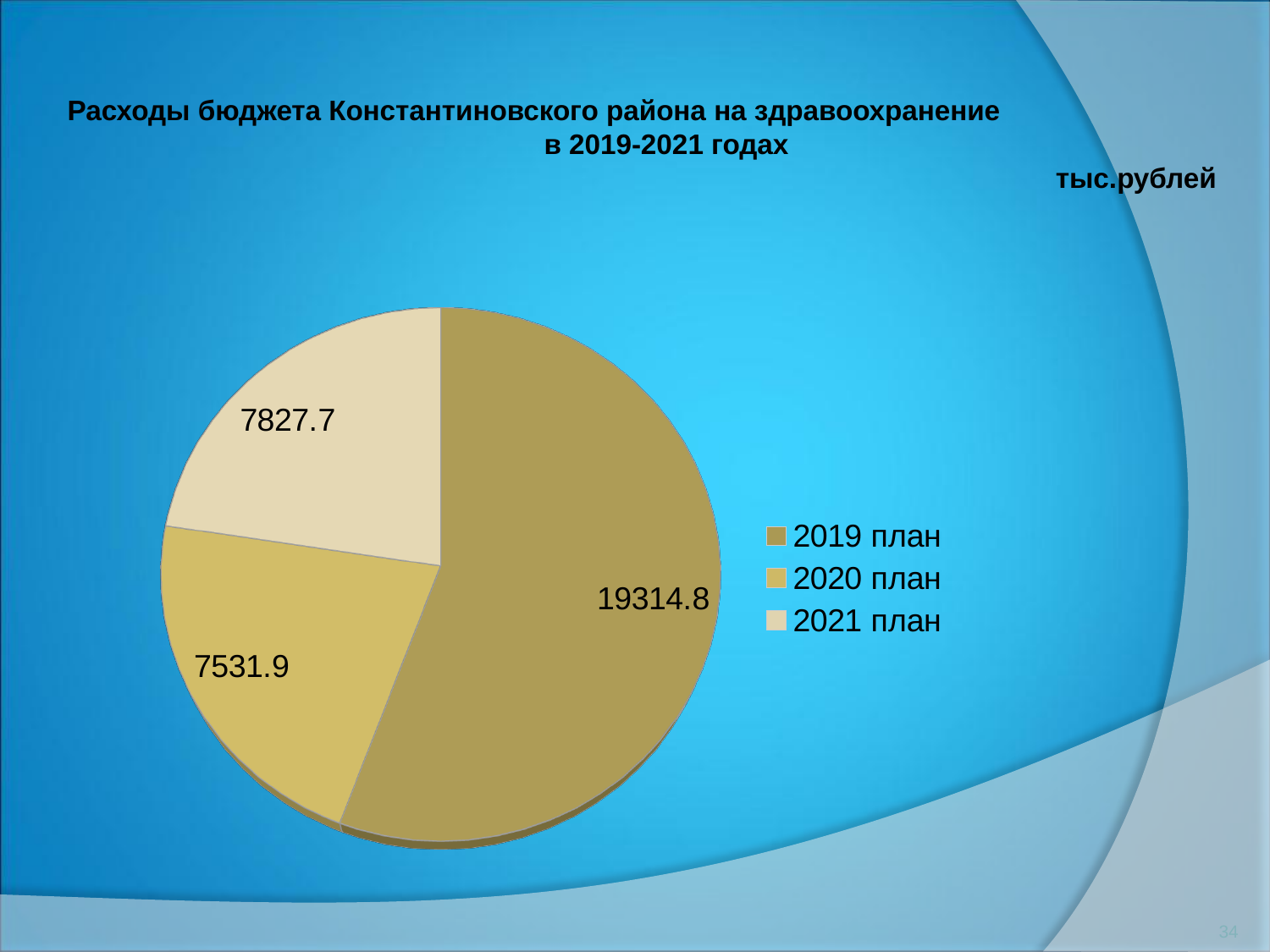
What is the value for 2019 план? 19314.8 What is the difference between the values for 2019 план and 2021 план? 11487.1 Which category has the largest slice of the pie? 2019 план What is the value for 2020 план? 7531.9 How many slices does the pie chart have? 3 In what units are the values on the chart expressed? тыс.рублей Which is larger, the value for 2020 план or 2021 план? 2021 план What is the difference between the values for 2021 план and 2020 план? 295.8 What kind of chart is shown on the slide? pie chart How many entries does the legend list? 3 Which category has the smallest value? 2020 план What is the value for 2021 план? 7827.7